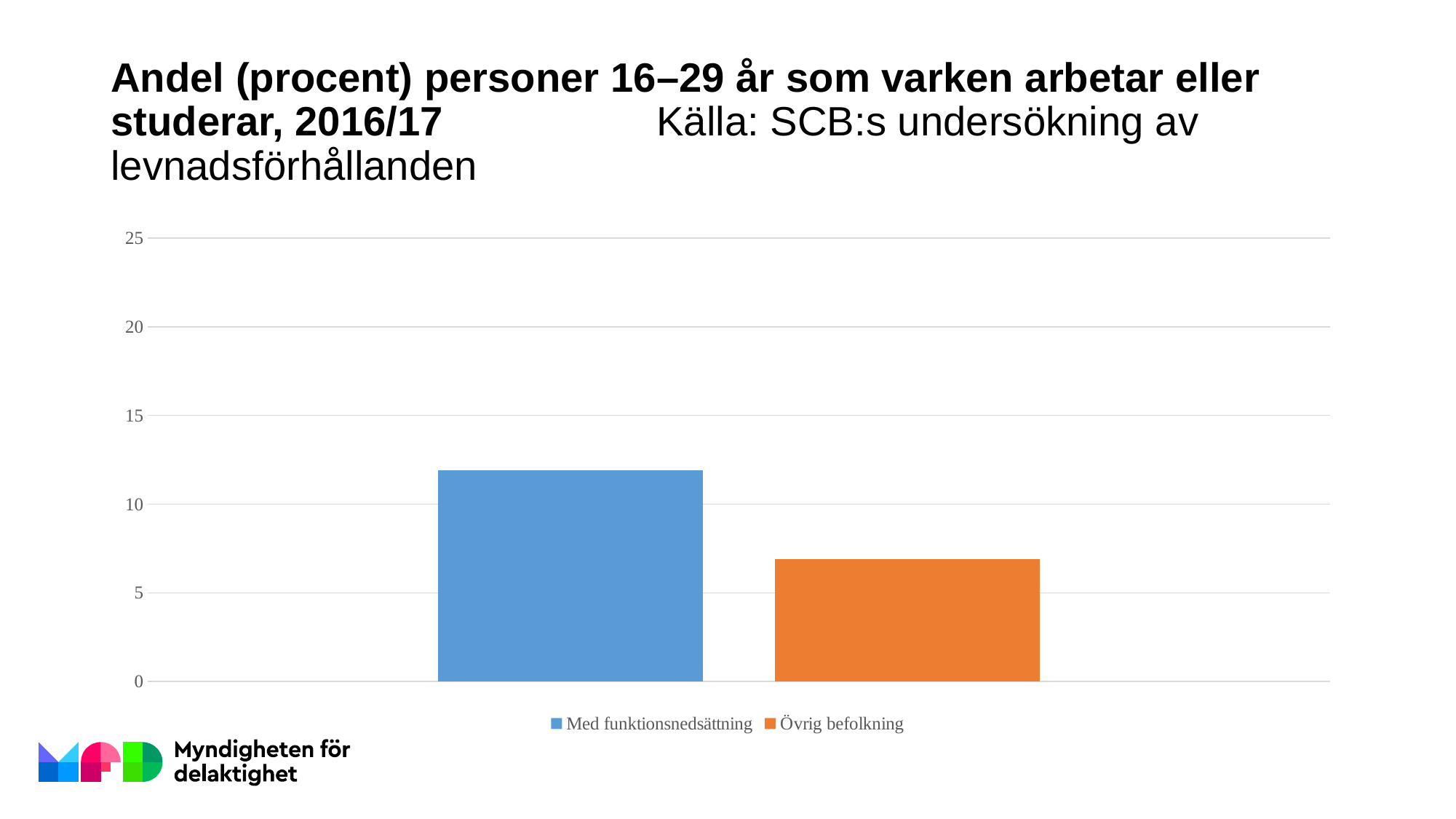
How many bars are plotted in the chart? 2 Is the value for Med funktionsnedsättning greater or less than 15? less Which is larger, the value for Med funktionsnedsättning or the value for Övrig befolkning? Med funktionsnedsättning Which group has the highest value in the chart? Med funktionsnedsättning What colour is the bar for Övrig befolkning? orange Which group has the lowest value in the chart? Övrig befolkning How many series does the legend list? 2 Is the value for Med funktionsnedsättning greater or less than 10? greater What kind of chart is shown on the slide? bar chart Is the value for Övrig befolkning greater or less than 10? less What is the highest value shown on the vertical axis? 25